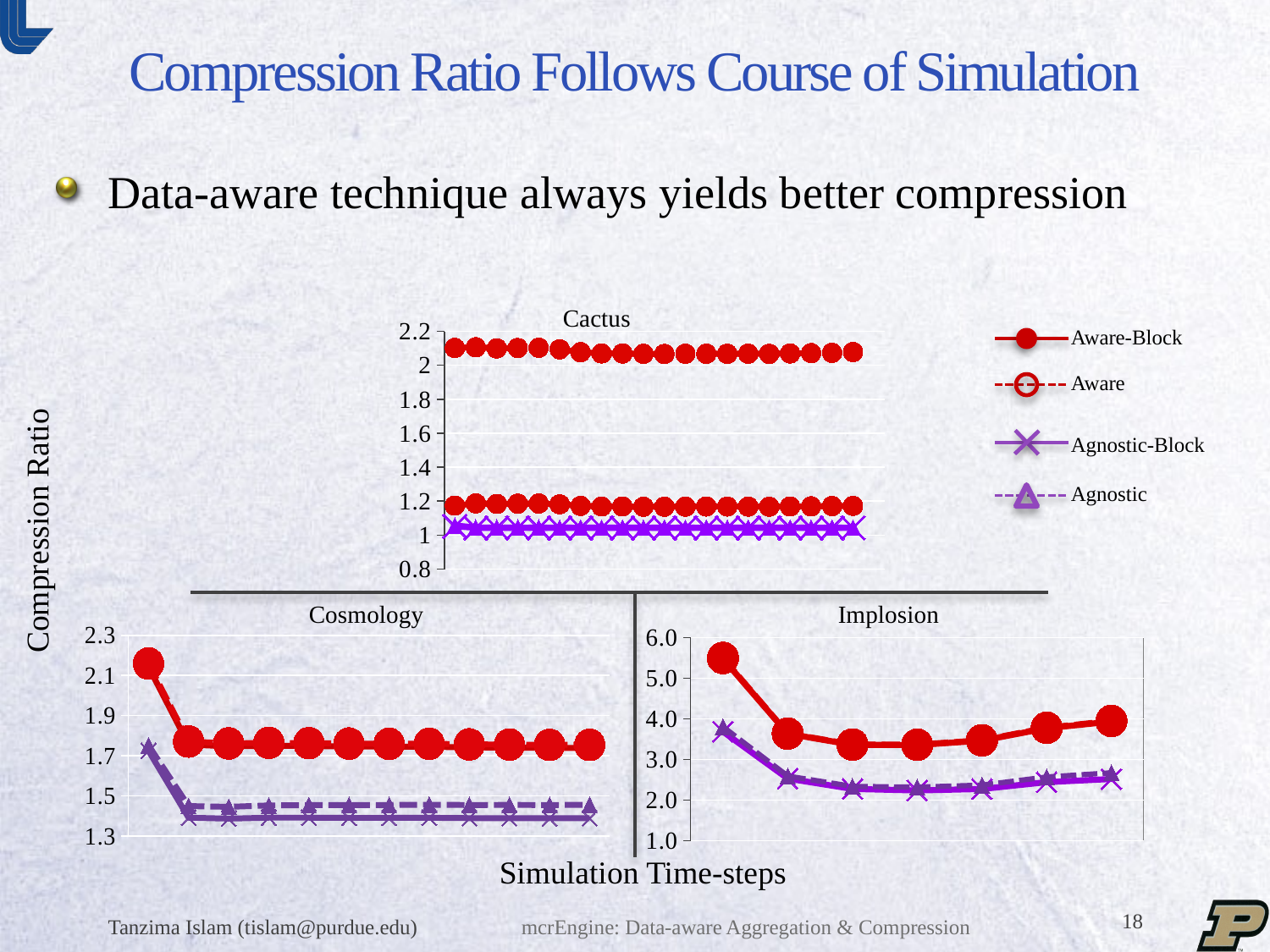
In the Implosion chart, is the last Agnostic value greater or less than 3.0? less What is the label on the shared y axis of the charts? Compression Ratio In the Cosmology chart, is the first Aware-Block value greater or less than 1.9? greater In the Implosion chart, does the Aware-Block series rise or fall between the first and second time-steps? fall How many charts are shown on the slide? 3 What is the label on the shared x axis of the charts? Simulation Time-steps In the Implosion chart, is the first Aware-Block value greater or less than 5.0? greater In the Cosmology chart, at the last time-step, which is larger: Aware-Block or Agnostic-Block? Aware-Block How many series does the legend list? 4 What kind of chart is the Cactus chart? line chart